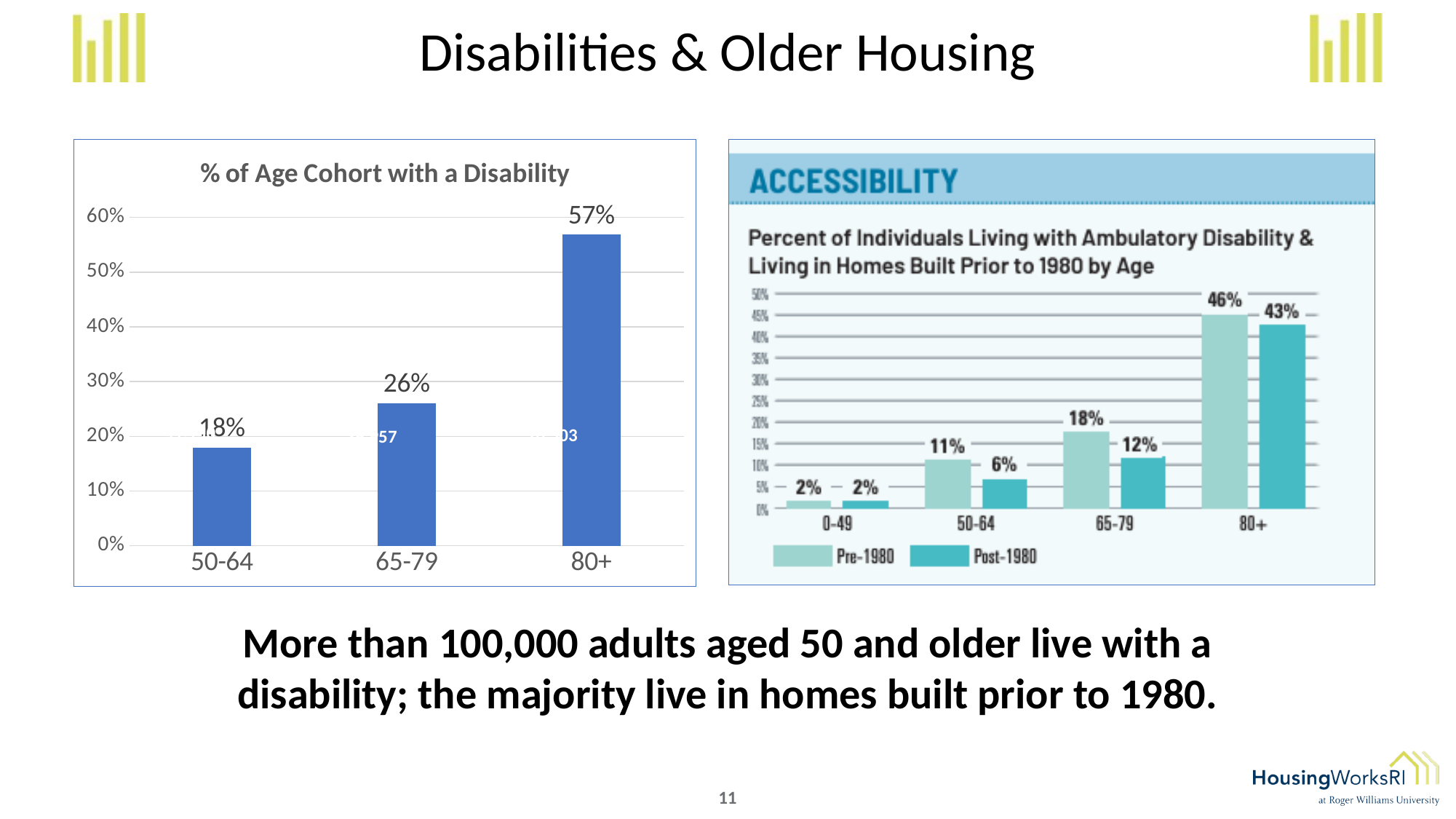
In the '% of Age Cohort with a Disability' chart, which age group has the lowest value? 50-64 In the '% of Age Cohort with a Disability' chart, what is the value for the 80+ age group? 57% What kind of chart is the '% of Age Cohort with a Disability' chart? bar chart In the Accessibility chart on the right, what is the Pre-1980 value for the 80+ age group? 46% In the '% of Age Cohort with a Disability' chart, how many age groups are shown? 3 In the Accessibility chart on the right, how many series does the legend list? 2 In the '% of Age Cohort with a Disability' chart, what is the value for the 65-79 age group? 26% In the Accessibility chart on the right, what is the Post-1980 value for the 65-79 age group? 12% In the '% of Age Cohort with a Disability' chart, what is the difference between the 80+ and 50-64 values? 39% In the '% of Age Cohort with a Disability' chart, do the values rise or fall as age increases along the x axis? rise In the Accessibility chart on the right, which is larger for the 50-64 age group: Pre-1980 or Post-1980? Pre-1980 In the Accessibility chart on the right, what is the difference between the Pre-1980 and Post-1980 values for the 65-79 age group? 6%